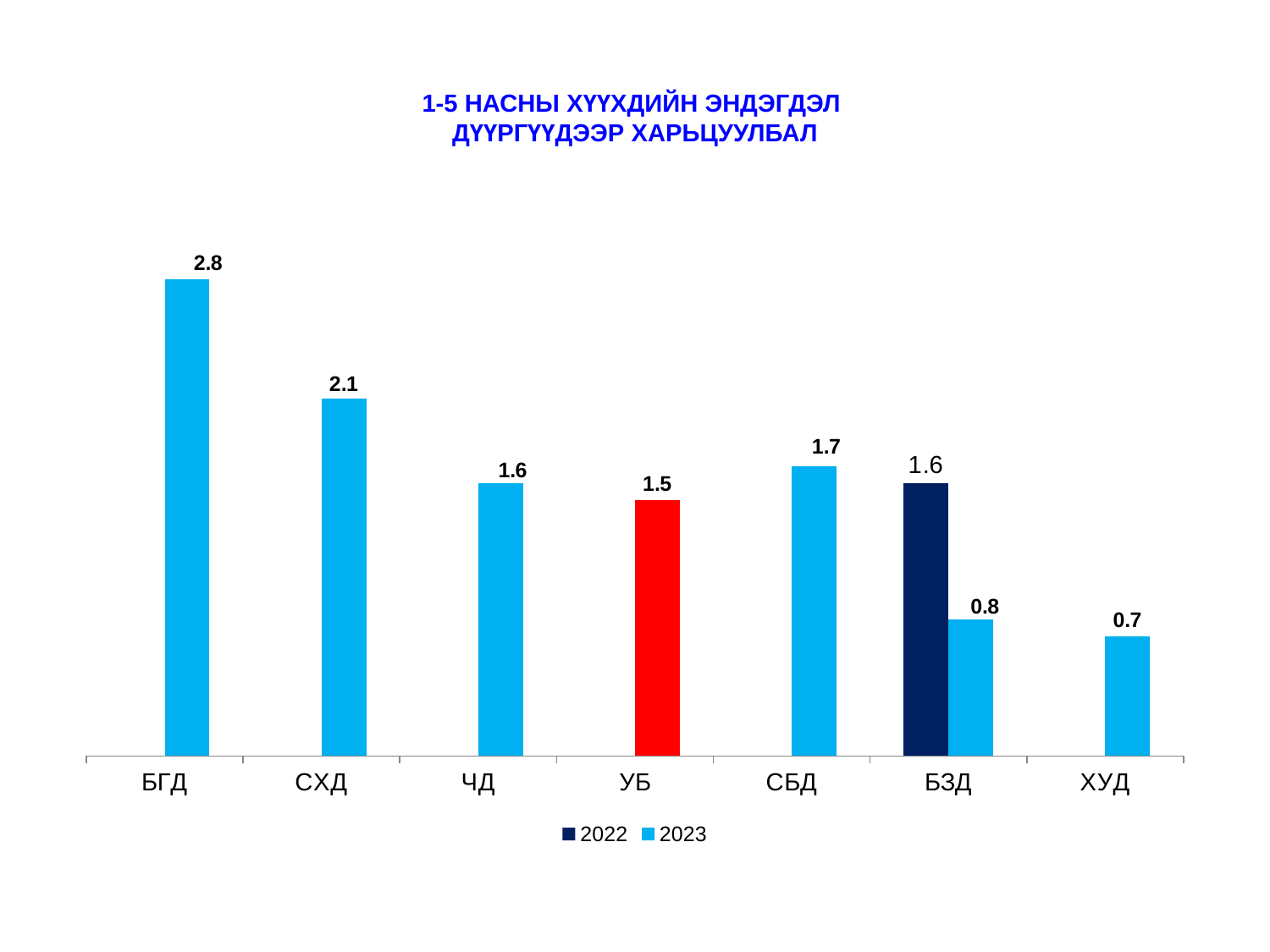
For БЗД, what is the difference between the 2022 and 2023 values? 0.8 What is the difference between the 2023 values for БГД and СХД? 0.7 Which category has the lowest 2023 value? ХУД How many categories are shown on the x axis? 7 What type of chart is shown on the slide? Bar chart What is the 2023 value for БГД? 2.8 What is the 2023 value for ХУД? 0.7 Which is larger, the 2023 value for СБД or the 2023 value for ЧД? СБД Which category has the highest 2023 value? БГД What is the 2023 value for СХД? 2.1 What is the 2022 value for БЗД? 1.6 How many series does the legend list? 2